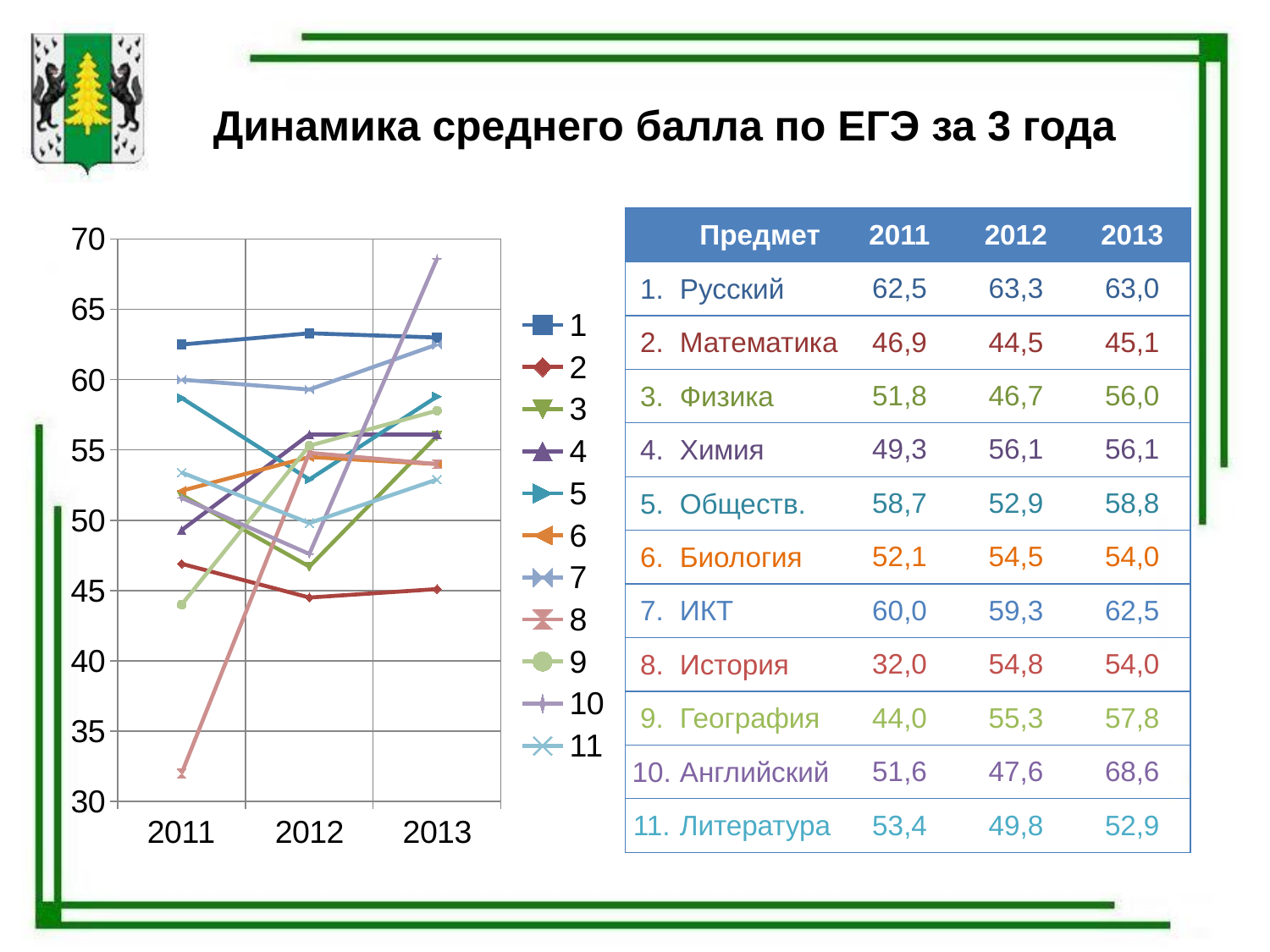
What kind of chart is shown on the slide? line chart Is the value for series 8 (История) in 2011 greater or less than 35? less By how much did the value for series 10 (Английский) change from 2012 to 2013? 21,0 How many series does the chart legend list? 11 What is the value for series 8 (История) in 2011? 32,0 How many years are plotted along the x axis of the chart? 3 What is the value for series 3 (Физика) in 2012? 46,7 Which series has the highest value in 2013? 10 (Английский) What is the value for series 10 (Английский) in 2013? 68,6 Which series has the lowest value in 2011? 8 (История) Does the value for series 9 (География) rise or fall from 2011 to 2013? rise In 2013, which is larger: series 5 (Обществ.) or series 6 (Биология)? series 5 (Обществ.)